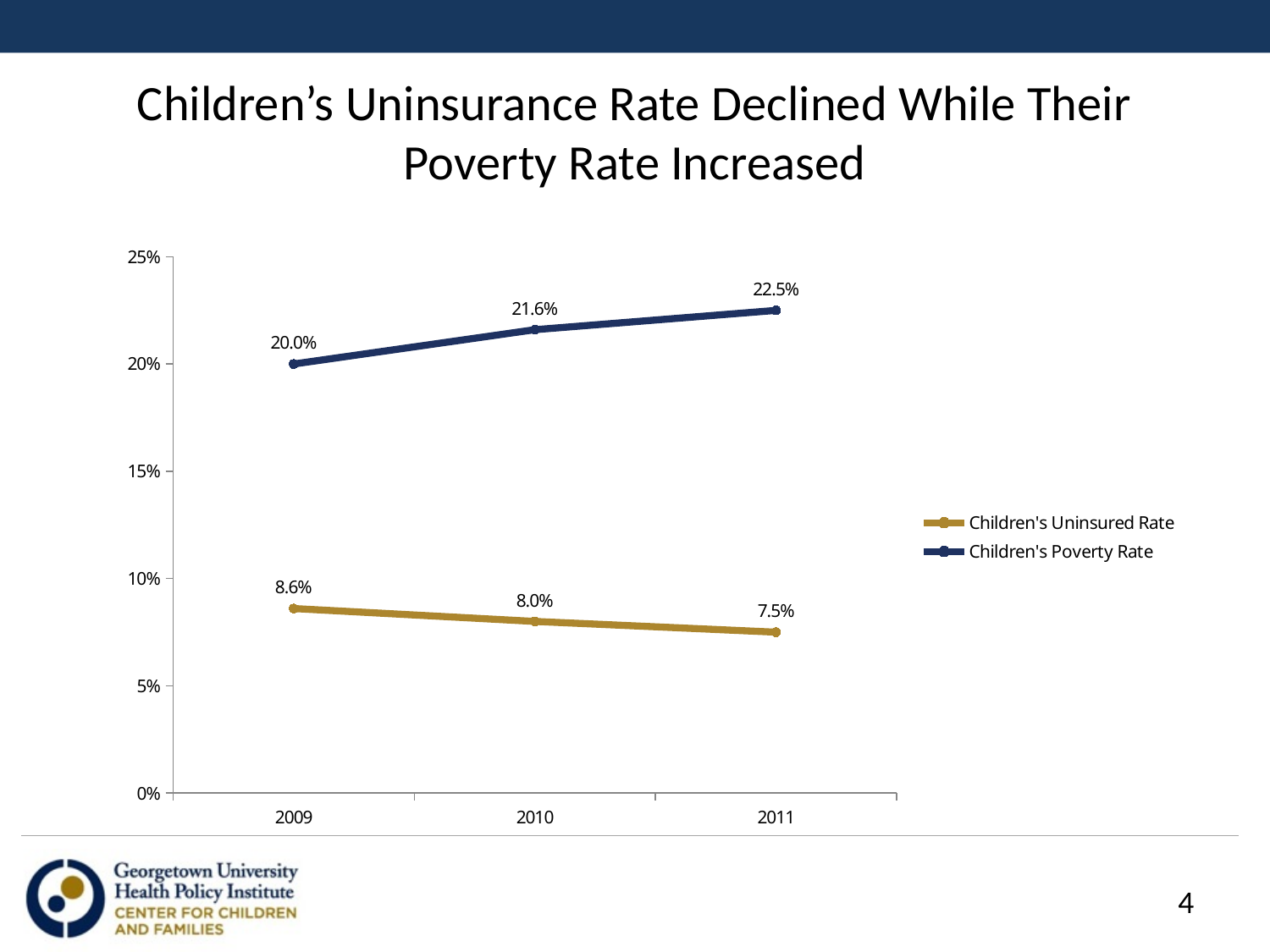
What kind of chart is shown on the slide? Line chart What was the Children's Uninsured Rate in 2010? 8.0% What was the Children's Poverty Rate in 2009? 20.0% In which year was the Children's Poverty Rate highest? 2011 How many series does the legend list? 2 By how many percentage points did the Children's Poverty Rate change from 2009 to 2011? 2.5 percentage points In which year was the Children's Uninsured Rate lowest? 2011 How does the Children's Uninsured Rate change from 2009 to 2011? It falls What was the Children's Uninsured Rate in 2009? 8.6% What is the difference between the Children's Poverty Rate and the Children's Uninsured Rate in 2010? 13.6 percentage points Which was higher in 2011, the Children's Uninsured Rate or the Children's Poverty Rate? Children's Poverty Rate What was the Children's Poverty Rate in 2011? 22.5%